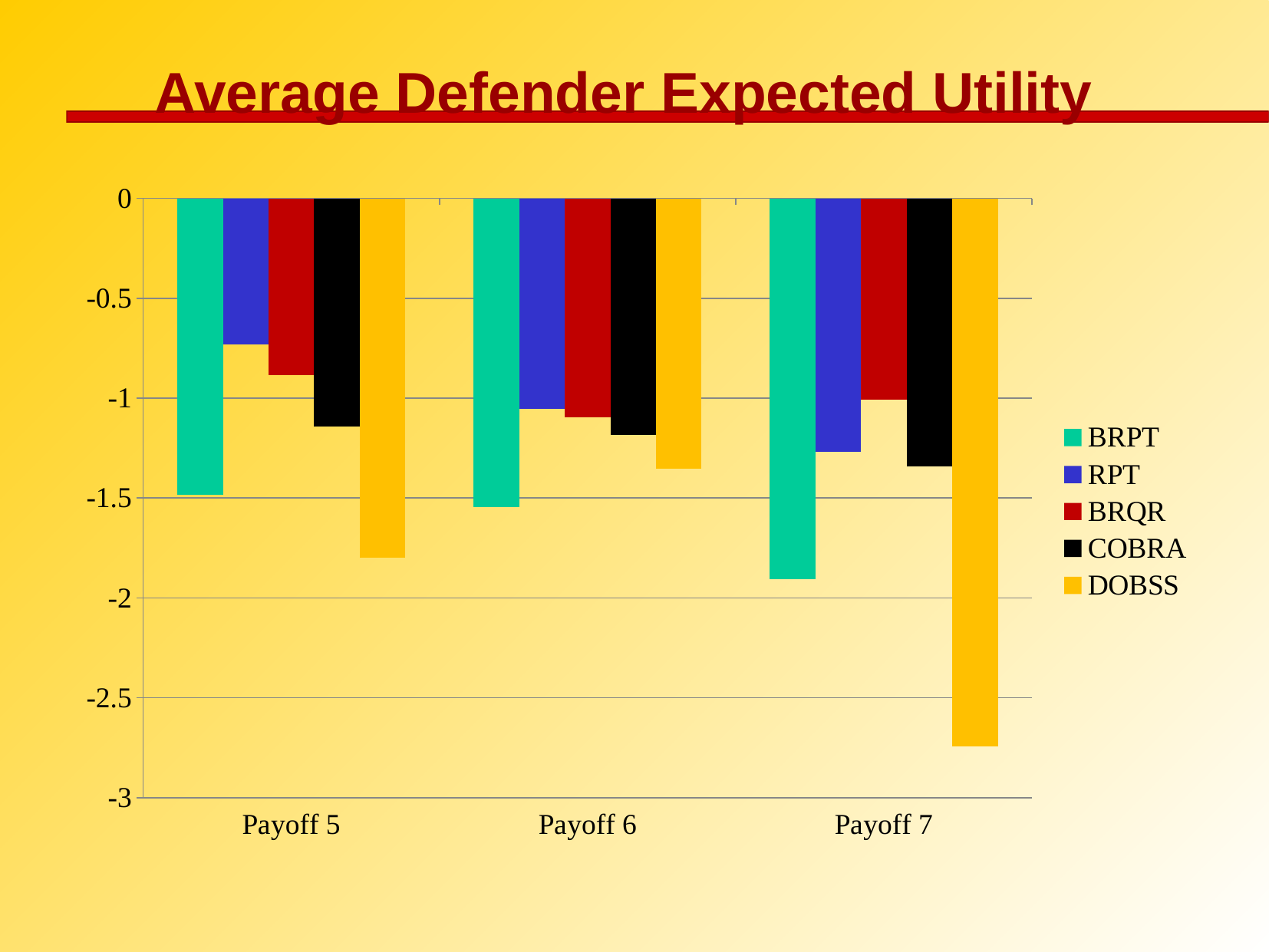
Which series has the highest value (closest to zero) for Payoff 5? RPT What is the title of the chart? Average Defender Expected Utility Is the value for BRPT at Payoff 7 greater or less than -2? greater Which series has the lowest value for Payoff 7? DOBSS For Payoff 6, which is larger: the value for BRPT or the value for DOBSS? DOBSS Which series has the highest value (closest to zero) for Payoff 7? BRQR Is the value for DOBSS at Payoff 7 greater or less than -2.5? less What kind of chart is shown on the slide? bar chart Do the BRPT values rise or fall from Payoff 5 to Payoff 7? fall Which series has the lowest value for Payoff 5? DOBSS How many series does the legend list? 5 How many payoff categories are shown on the x axis? 3